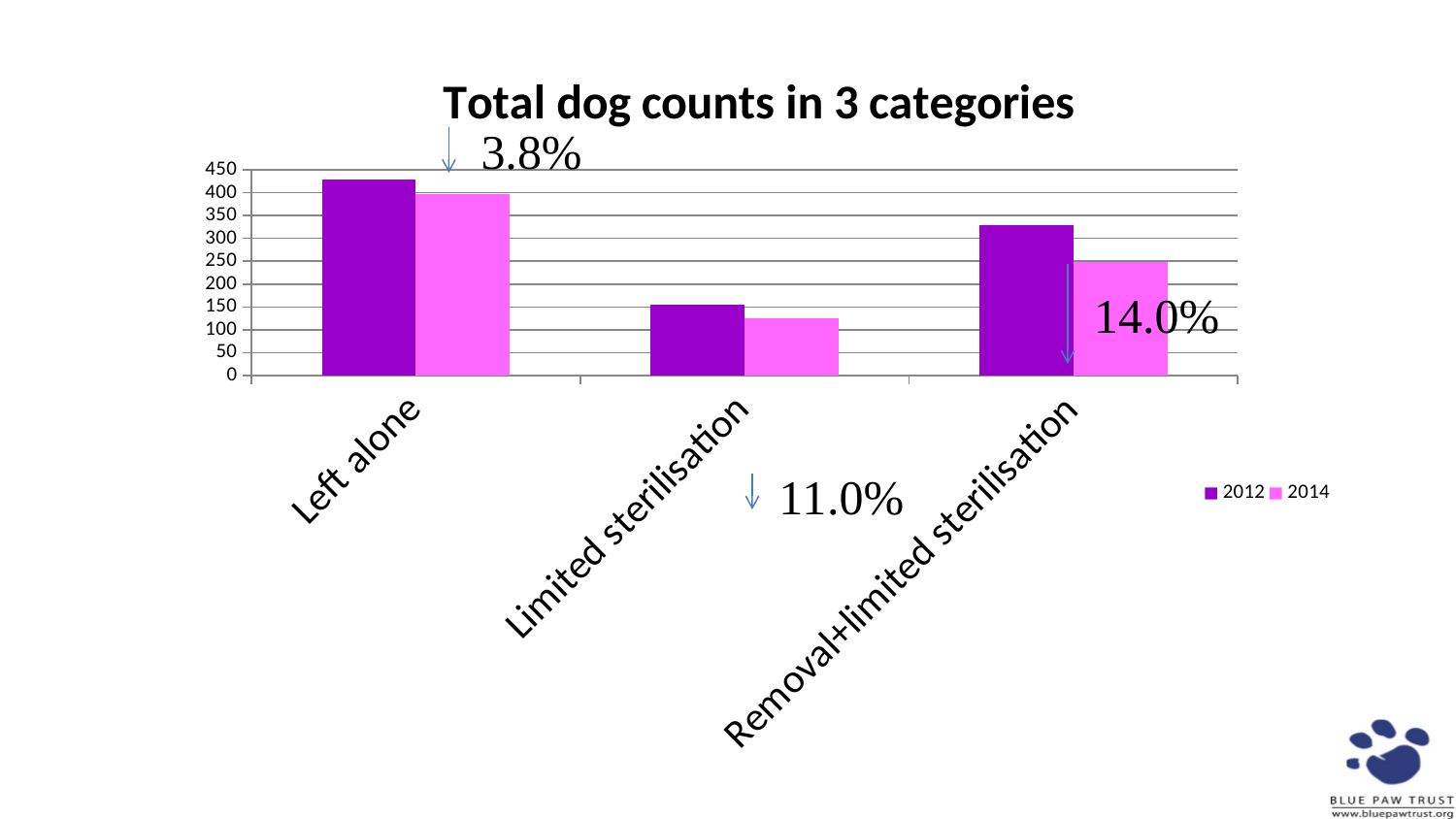
What percentage decrease is annotated next to the Removal+limited sterilisation bars? 14.0% What kind of chart is shown on the slide? bar chart Is the 2012 value for Left alone greater or less than 400? greater What is the title of the chart? Total dog counts in 3 categories How many series does the chart's legend list? 2 Is the 2014 value for Limited sterilisation greater or less than 150? less Which category has the lowest 2014 value? Limited sterilisation Which is larger, the 2014 value for Left alone or the 2014 value for Removal+limited sterilisation? Left alone For Removal+limited sterilisation, which is larger, the 2012 value or the 2014 value? 2012 Which category has the highest 2012 value? Left alone Which category has the lowest 2012 value? Limited sterilisation How many categories are shown on the x axis of the chart? 3